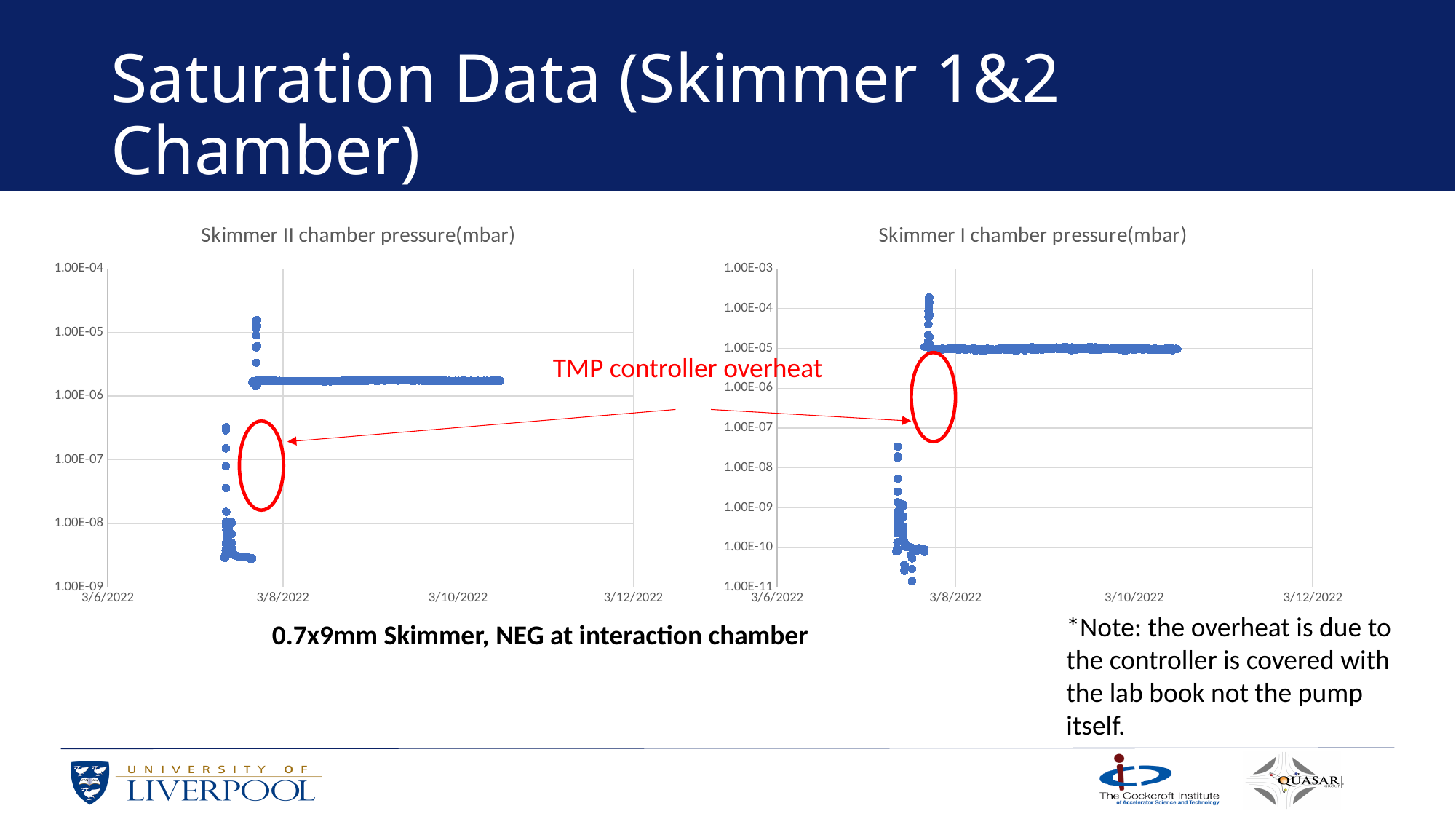
What kind of chart is the 'Skimmer I chamber pressure(mbar)' chart? scatter chart In the 'Skimmer I chamber pressure(mbar)' chart, is the long flat plateau of points after 3/8/2022 greater or less than 1.00E-04? less What kind of chart is the 'Skimmer II chamber pressure(mbar)' chart? scatter chart What is the title of the chart on the right of the slide? Skimmer I chamber pressure(mbar) In the 'Skimmer II chamber pressure(mbar)' chart, what is the first date label on the x axis? 3/6/2022 What is the title of the chart on the left of the slide? Skimmer II chamber pressure(mbar) In the 'Skimmer II chamber pressure(mbar)' chart, what is the highest value shown on the y axis? 1.00E-04 In the 'Skimmer II chamber pressure(mbar)' chart, is the long flat plateau of points after 3/8/2022 greater or less than 1.00E-06? greater How many charts are shown on the slide? 2 In the 'Skimmer I chamber pressure(mbar)' chart, what is the lowest value shown on the y axis? 1.00E-11 In the 'Skimmer I chamber pressure(mbar)' chart, do the pressure values overall rise or fall from 3/6/2022 to 3/10/2022? rise In the 'Skimmer II chamber pressure(mbar)' chart, is the long flat plateau of points after 3/8/2022 greater or less than 1.00E-05? less